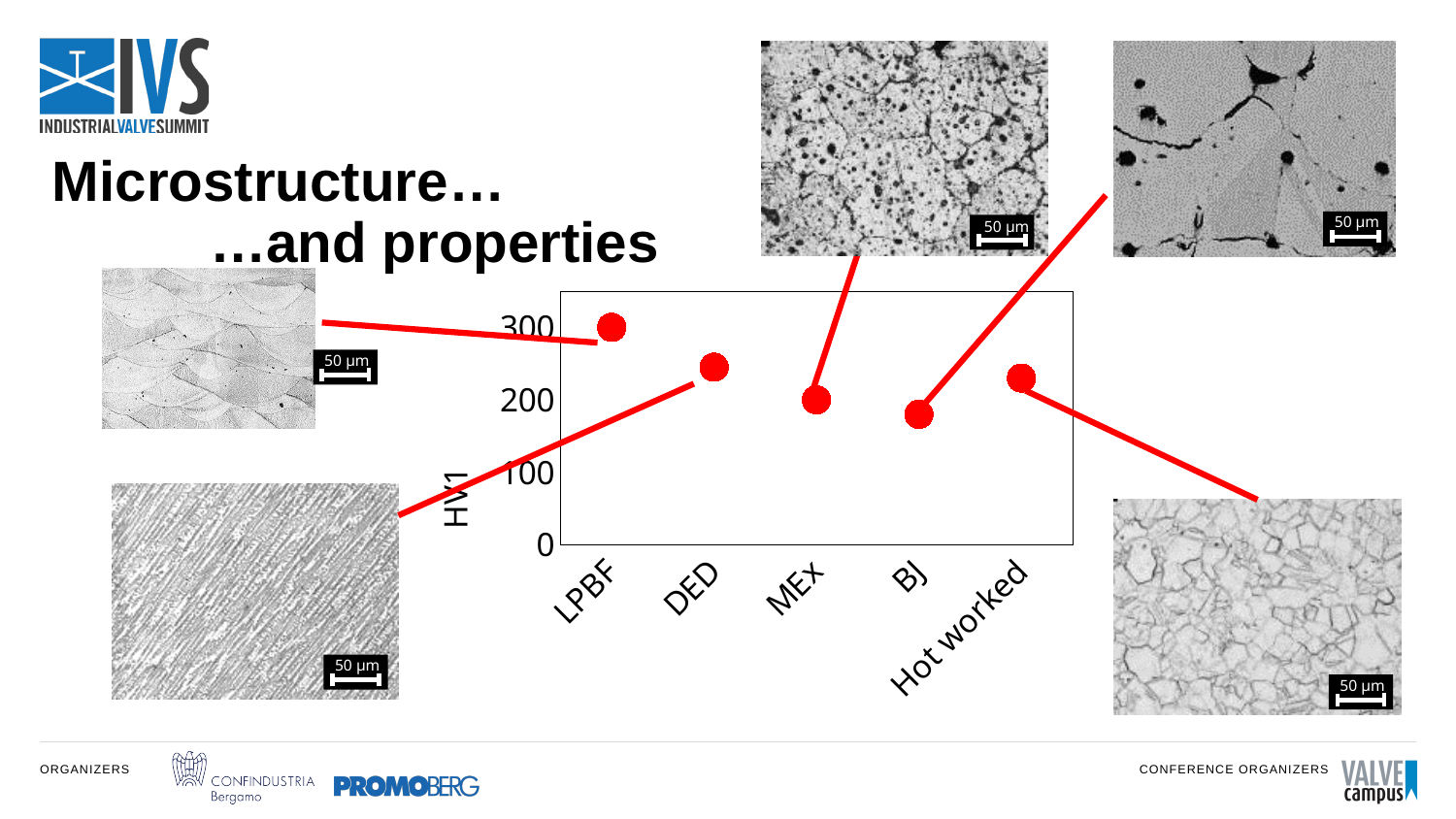
Is the HV1 value for BJ greater or less than 100? greater How many categories are plotted on the x axis of the chart? 5 Which has the larger HV1 value, LPBF or MEx? LPBF Which category has the highest HV1 value in the chart? LPBF Is the HV1 value for DED greater or less than 200? greater Which has the larger HV1 value, DED or BJ? DED Is the HV1 value for Hot worked greater or less than 200? greater Which category has the lowest HV1 value in the chart? BJ Do the HV1 values rise or fall going from LPBF to BJ along the x axis? fall What is the label on the y axis of the chart? HV1 What kind of chart is shown on the slide? scatter (dot) chart